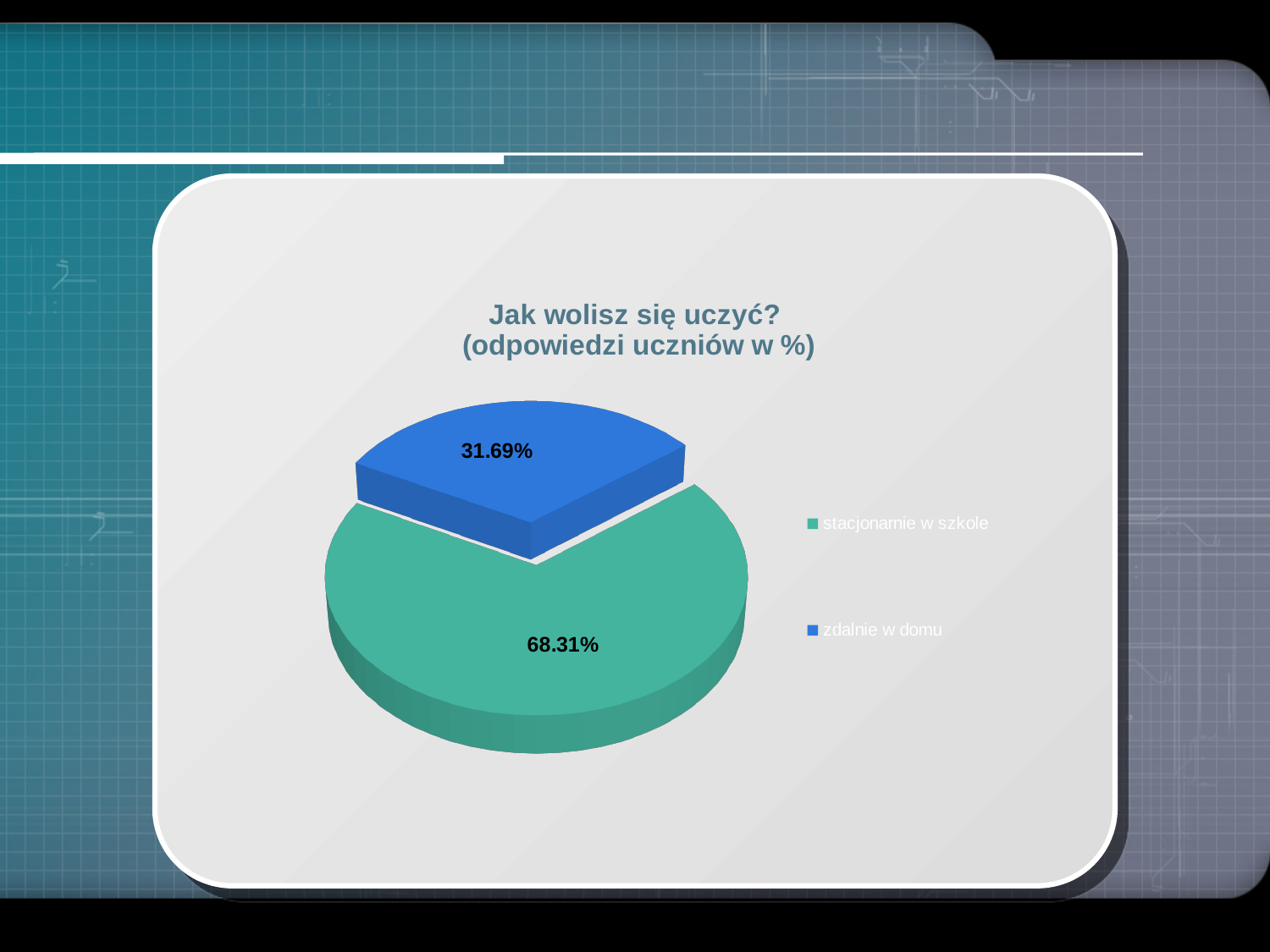
What is the difference in percentage points between "stacjonarnie w szkole" and "zdalnie w domu"? 36.62 What is the title of the chart? Jak wolisz się uczyć? (odpowiedzi uczniów w %) What percentage of students chose "stacjonarnie w szkole"? 68.31% What percentage of students chose "zdalnie w domu"? 31.69% How many entries does the legend list? 2 What kind of chart is shown on the slide? pie chart Which is larger: the share for "stacjonarnie w szkole" or for "zdalnie w domu"? stacjonarnie w szkole How many slices does the pie chart have? 2 Which category has the smallest share of the pie? zdalnie w domu What colour is the slice for "zdalnie w domu"? blue Which category has the largest share of the pie? stacjonarnie w szkole